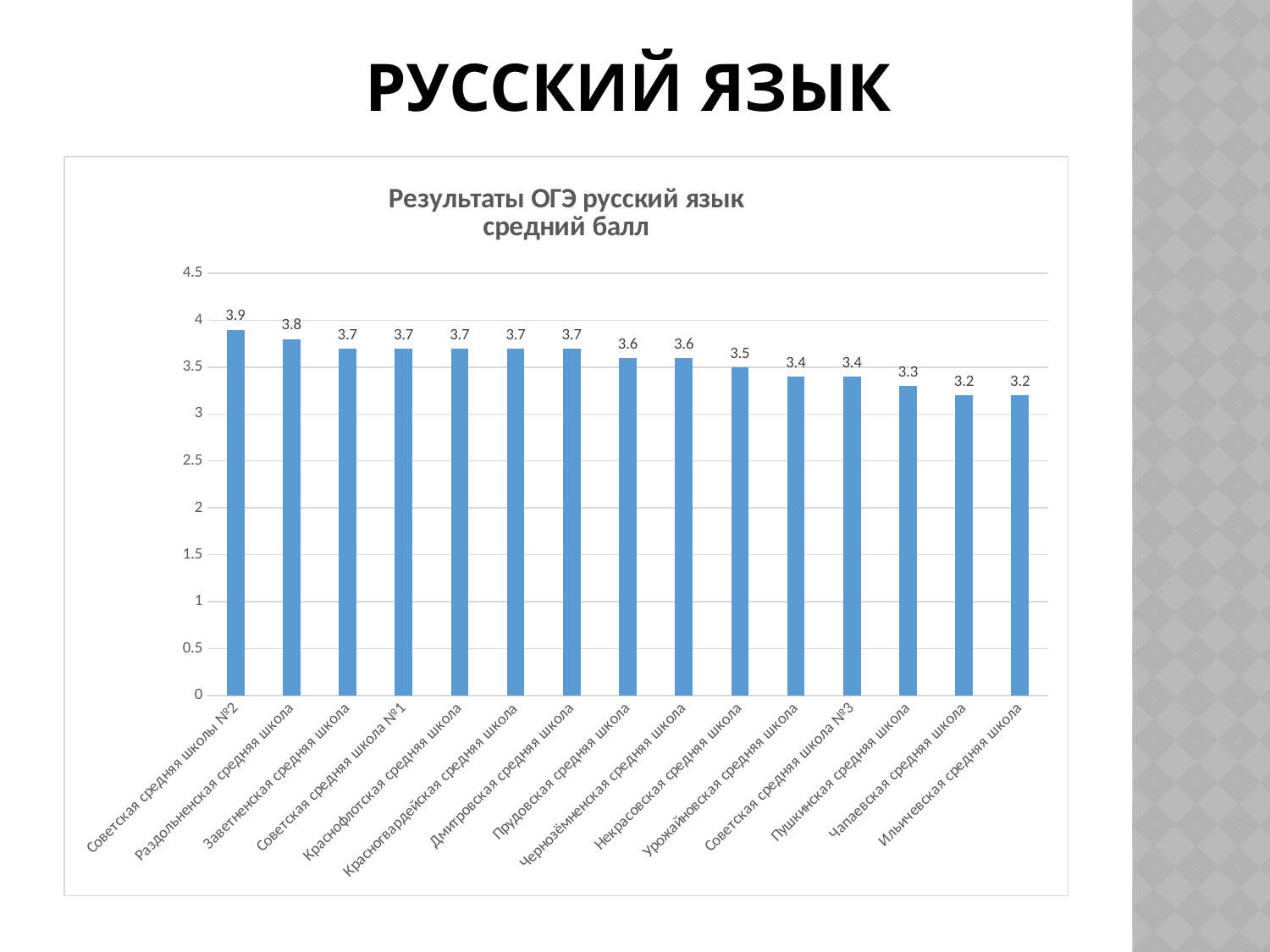
What kind of chart is shown on the slide? Bar chart What is the difference between the average scores of Советская средняя школы №2 and Ильичевская средняя школа? 0.7 Do the average scores rise or fall from left to right across the chart? Fall What is the title of the chart? Результаты ОГЭ русский язык средний балл Which has a higher average score, Раздольненская средняя школа or Урожайновская средняя школа? Раздольненская средняя школа What is the average score for Прудовская средняя школа? 3.6 Which school has the highest average score? Советская средняя школы №2 How many schools are shown on the chart? 15 What is the lowest average score shown on the chart? 3.2 What is the average score for Пушкинская средняя школа? 3.3 What is the average score for Раздольненская средняя школа? 3.8 What is the average score for Некрасовская средняя школа? 3.5